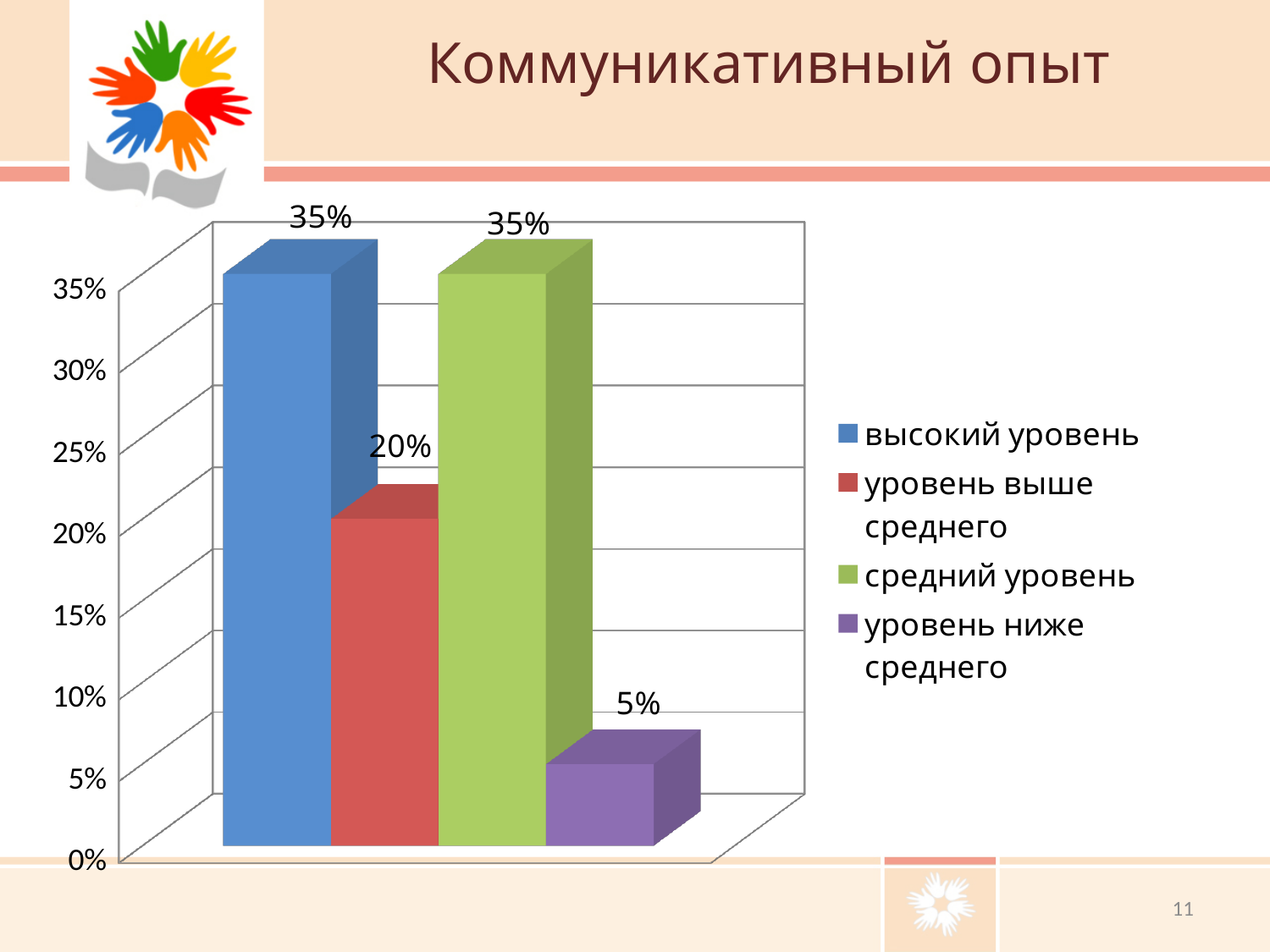
What is the title of the slide containing the chart? Коммуникативный опыт What is the difference between the values for высокий уровень and уровень выше среднего? 15% Which category has the lowest value? уровень ниже среднего How many entries does the legend list? 4 What is the value for средний уровень? 35% What is the value for уровень ниже среднего? 5% Is the value for уровень выше среднего greater or less than 15%? greater What is the difference between the values for средний уровень and уровень ниже среднего? 30% What is the value for высокий уровень? 35% How many bars are plotted in the chart? 4 What is the value for уровень выше среднего? 20% Which is larger, the value for уровень выше среднего or the value for уровень ниже среднего? уровень выше среднего